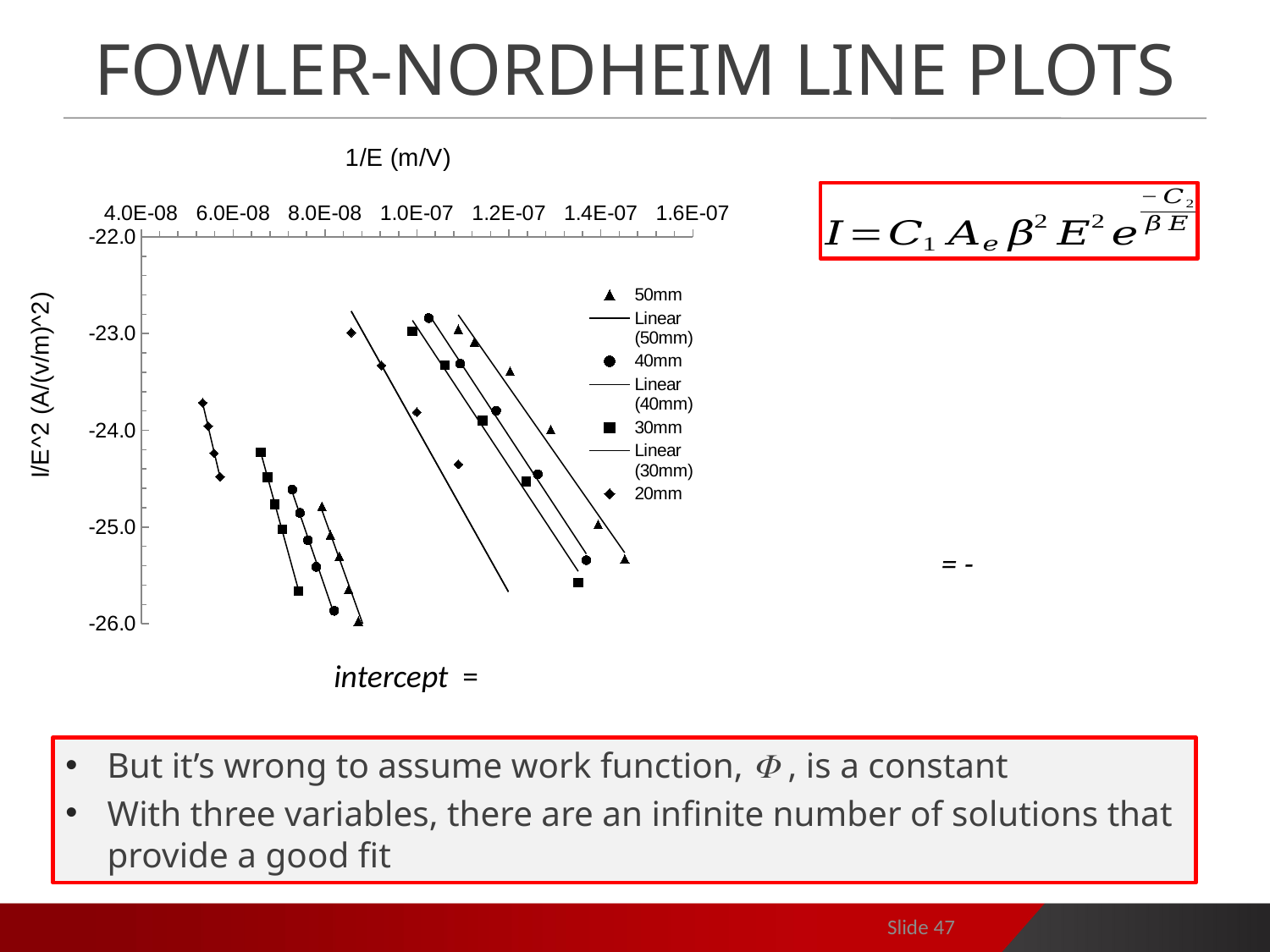
What kind of chart is shown on the slide? Scatter plot How many entries does the chart legend list? 7 How many marker (data point) series are shown in the legend, excluding the linear fit lines? 4 What is the title of the x axis? 1/E (m/V) What is the lowest tick value shown on the y axis? -26.0 Which series is listed first in the legend? 50mm Are the 20mm diamond points near 1/E = 6.0E-08 greater or less than -25.0 on the y axis? greater Do the plotted values rise or fall as 1/E increases along the x axis? Fall